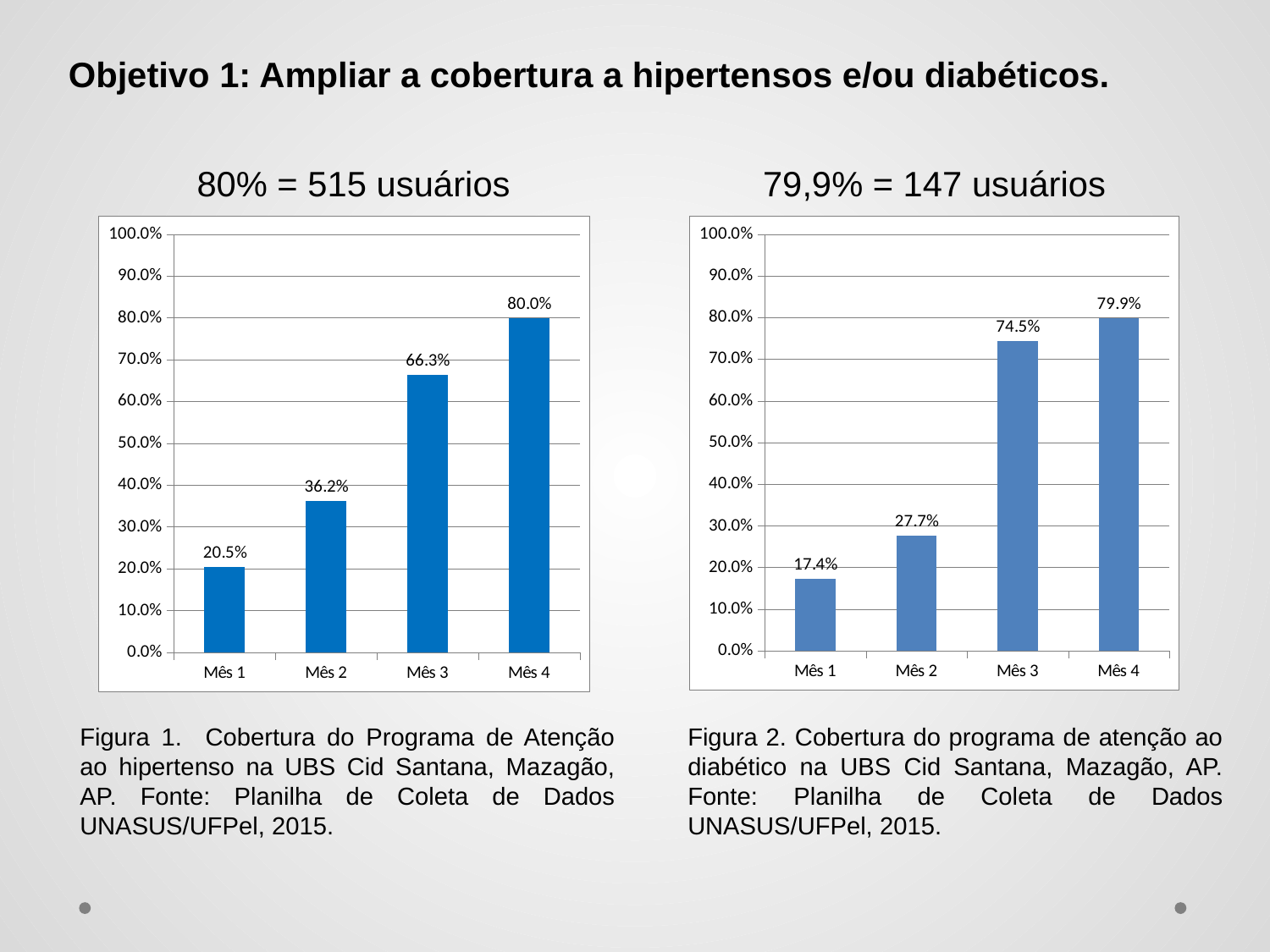
In the right chart (Figura 2, diabéticos), is the value for Mês 1 greater or less than 20.0%? less In the left chart (Figura 1, hipertensos), which month has the lowest value? Mês 1 What kind of chart is the right chart (Figura 2, diabéticos)? bar chart According to the text above the left chart, how many users does 80% correspond to? 515 usuários In the left chart (Figura 1, hipertensos), which is larger, the value for Mês 2 or Mês 3? Mês 3 In the left chart (Figura 1, hipertensos), what is the difference between Mês 4 and Mês 1? 59.5% In the right chart (Figura 2, diabéticos), do the values rise or fall from Mês 1 to Mês 4? rise In the left chart (Figura 1, hipertensos), what is the value for Mês 3? 66.3% In the right chart (Figura 2, diabéticos), what is the value for Mês 2? 27.7% How many months are shown on the x axis of the left chart (Figura 1, hipertensos)? 4 In the right chart (Figura 2, diabéticos), which month has the highest value? Mês 4 In the right chart (Figura 2, diabéticos), what is the difference between Mês 3 and Mês 2? 46.8%